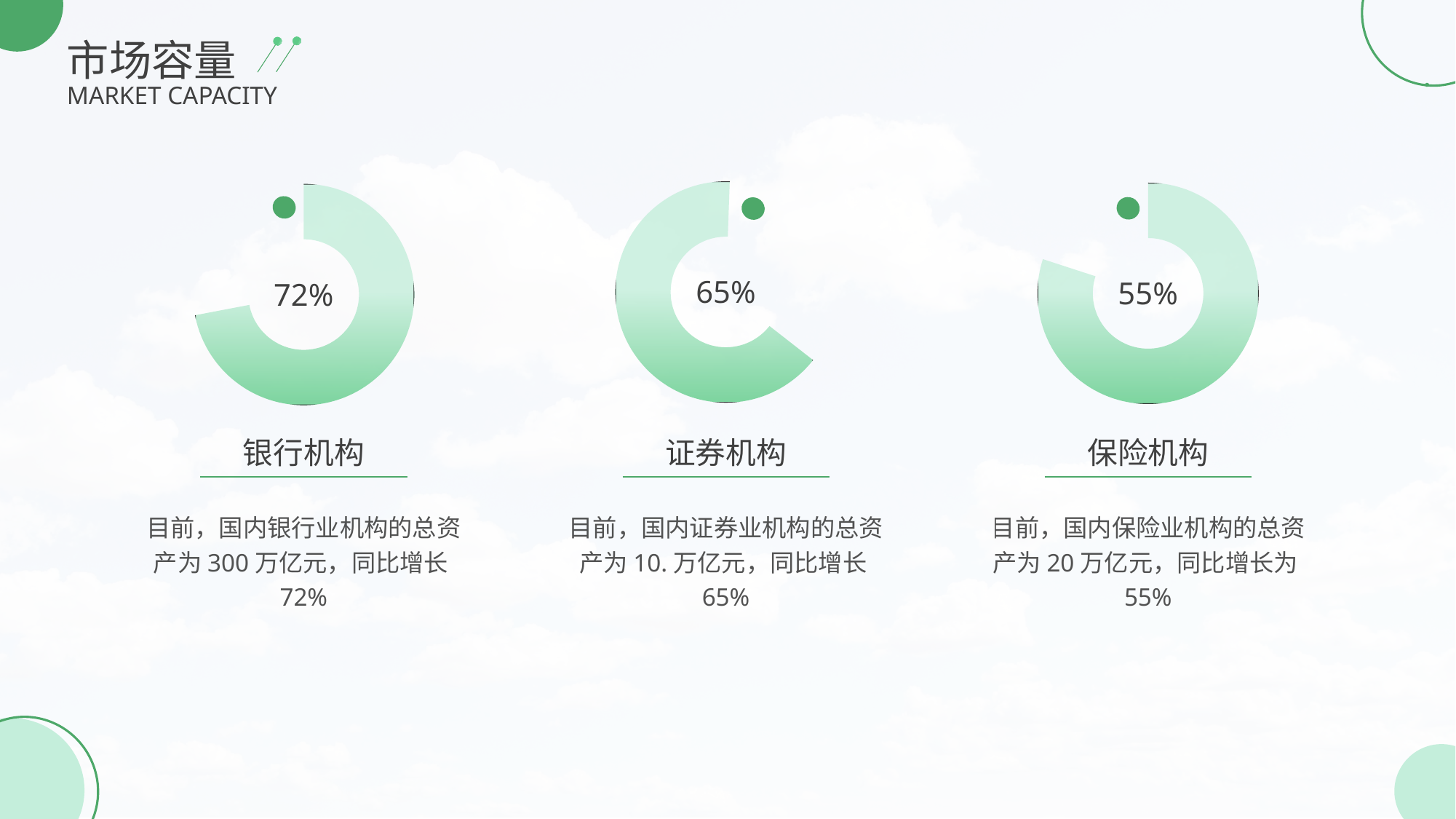
How many donut charts are on the slide? 3 What is the title of the slide containing the three donut charts? 市场容量 What percentage is shown in the centre of the 证券机构 donut chart? 65% What is the difference between the percentage in the 银行机构 chart and the percentage in the 保险机构 chart? 17% Which of the three donut charts shows the lowest percentage? 保险机构 What percentage is shown in the centre of the 银行机构 donut chart? 72% What is the difference between the percentage in the 证券机构 chart and the percentage in the 保险机构 chart? 10% What is the English subtitle shown under the slide title above the donut charts? MARKET CAPACITY Which is larger, the percentage in the 银行机构 chart or the percentage in the 证券机构 chart? 银行机构 What percentage is shown in the centre of the 保险机构 donut chart? 55% Which of the three donut charts shows the highest percentage? 银行机构 What kind of chart is used for 银行机构, 证券机构 and 保险机构? Donut chart